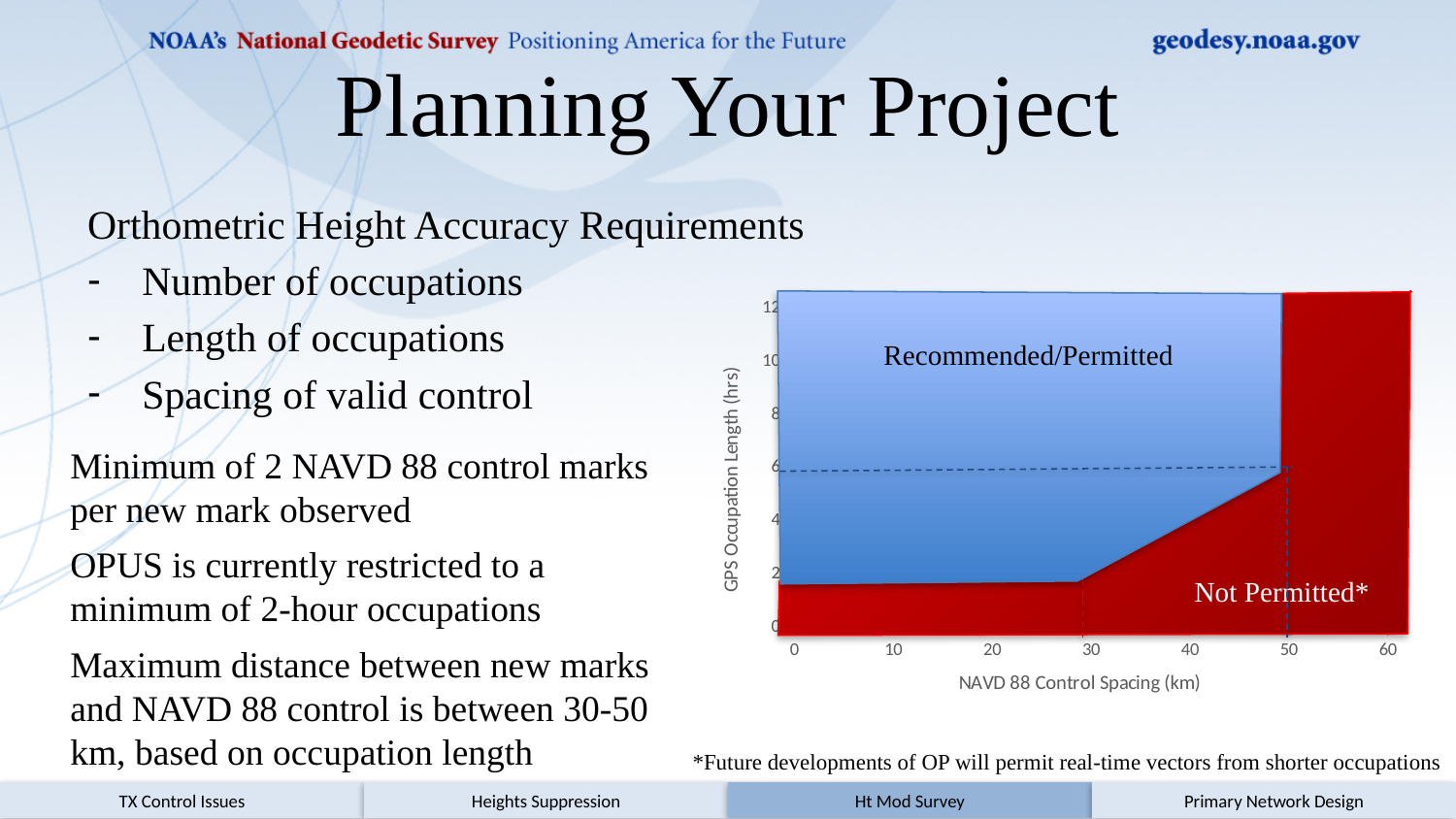
What is the highest value shown on the y axis of the chart? 12 How many tick labels are shown on the x axis of the chart? 7 Which region is larger in the chart, the blue region or the red region? blue region What kind of chart is shown on the slide? area chart What label is shown in the blue region of the chart? Recommended/Permitted Is the minimum occupation length at the boundary of the blue region at 10 km spacing greater or less than 4 hours? less What is the title of the x axis of the chart? NAVD 88 Control Spacing (km) Is the minimum occupation length at the boundary of the blue region at 40 km spacing greater or less than 2 hours? greater What is the highest value shown on the x axis of the chart? 60 Is the control spacing at which the blue region ends greater or less than 40 km? greater Between 30 km and 50 km of control spacing, does the lower boundary of the blue region rise or fall as spacing increases? rise